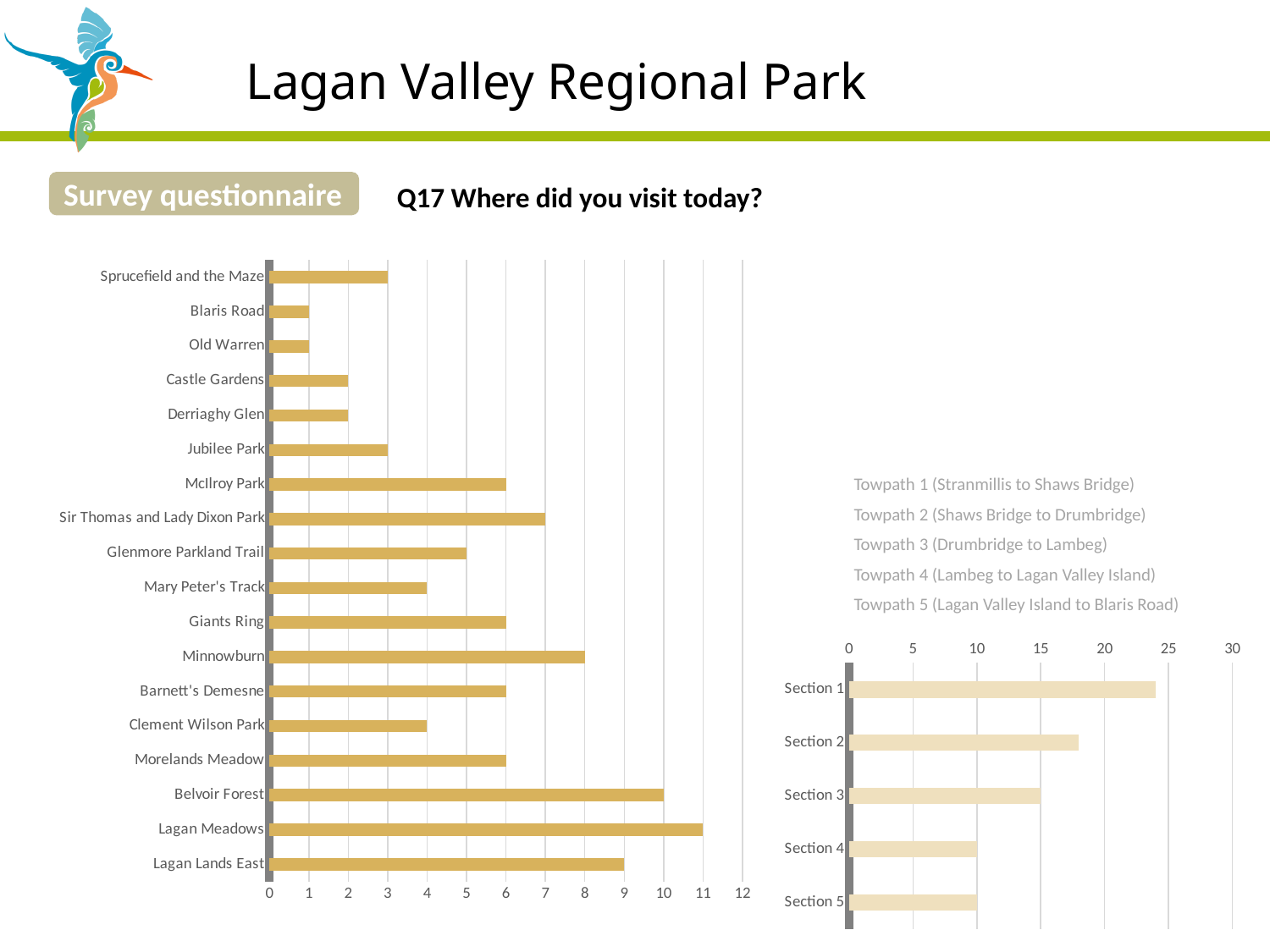
In the left chart, what is the value for Minnowburn? 8 How many locations are shown in the left chart? 18 How many sections are shown in the right chart? 5 In the left chart, what is the value for Belvoir Forest? 10 In the left chart, what is the value for Lagan Meadows? 11 What type of chart is the left chart? Bar chart In the right chart, which section has the highest value? Section 1 In the right chart, is the value for Section 1 greater or less than 20? greater In the left chart, what is the difference between the values for Lagan Lands East and Sir Thomas and Lady Dixon Park? 2 In the left chart, which has a larger value, Glenmore Parkland Trail or Mary Peter's Track? Glenmore Parkland Trail In the right chart, what is the value for Section 3? 15 In the left chart, which location has the highest value? Lagan Meadows